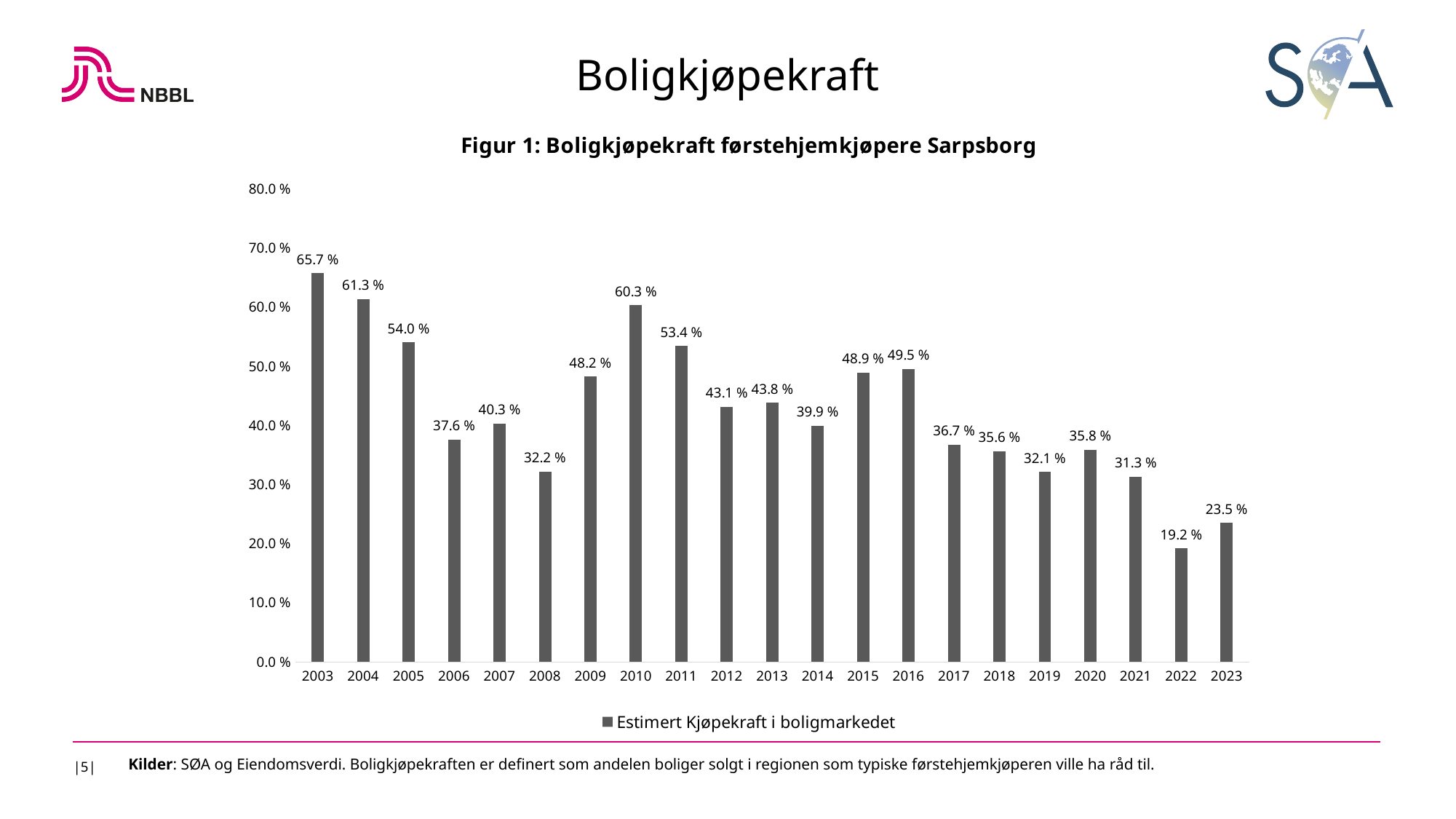
What is the value for 2022? 19.2 % What is the legend entry for the series? Estimert Kjøpekraft i boligmarkedet What is the value for 2010? 60.3 % What kind of chart is shown? bar chart What is the value for 2016? 49.5 % Which year has the lowest value? 2022 How many series does the legend list? 1 Is the value for 2008 greater or less than 40.0 %? less What is the difference between the values for 2003 and 2023? 42.2 % Which year has the highest value? 2003 Which is larger, the value for 2009 or the value for 2015? 2015 How many years are shown on the x axis? 21